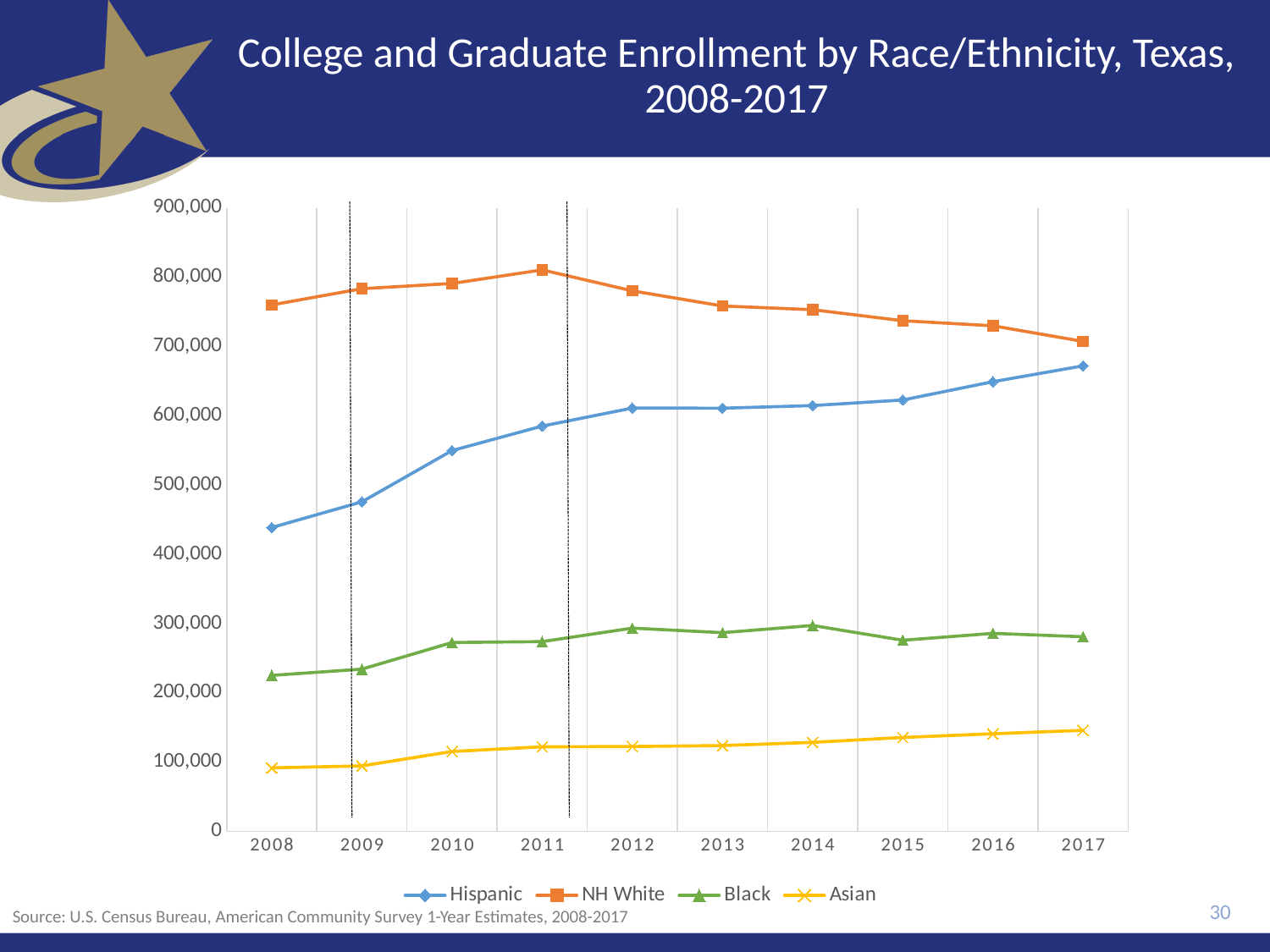
What is the title of the chart? College and Graduate Enrollment by Race/Ethnicity, Texas, 2008-2017 What kind of chart is shown on the slide? line chart Which series has the lowest enrollment in 2017? Asian In which year does the NH White series reach its highest value? 2011 Is the Asian value for 2017 greater or less than 100,000? greater Does the Hispanic series rise or fall from 2008 to 2017? rise How many years are plotted along the x axis? 10 Does the NH White series rise or fall from 2011 to 2017? fall How many series does the legend list? 4 Which series has the highest enrollment in 2008? NH White In 2012, which is larger: the Black value or the Asian value? Black Is the Hispanic value for 2008 greater or less than 500,000? less